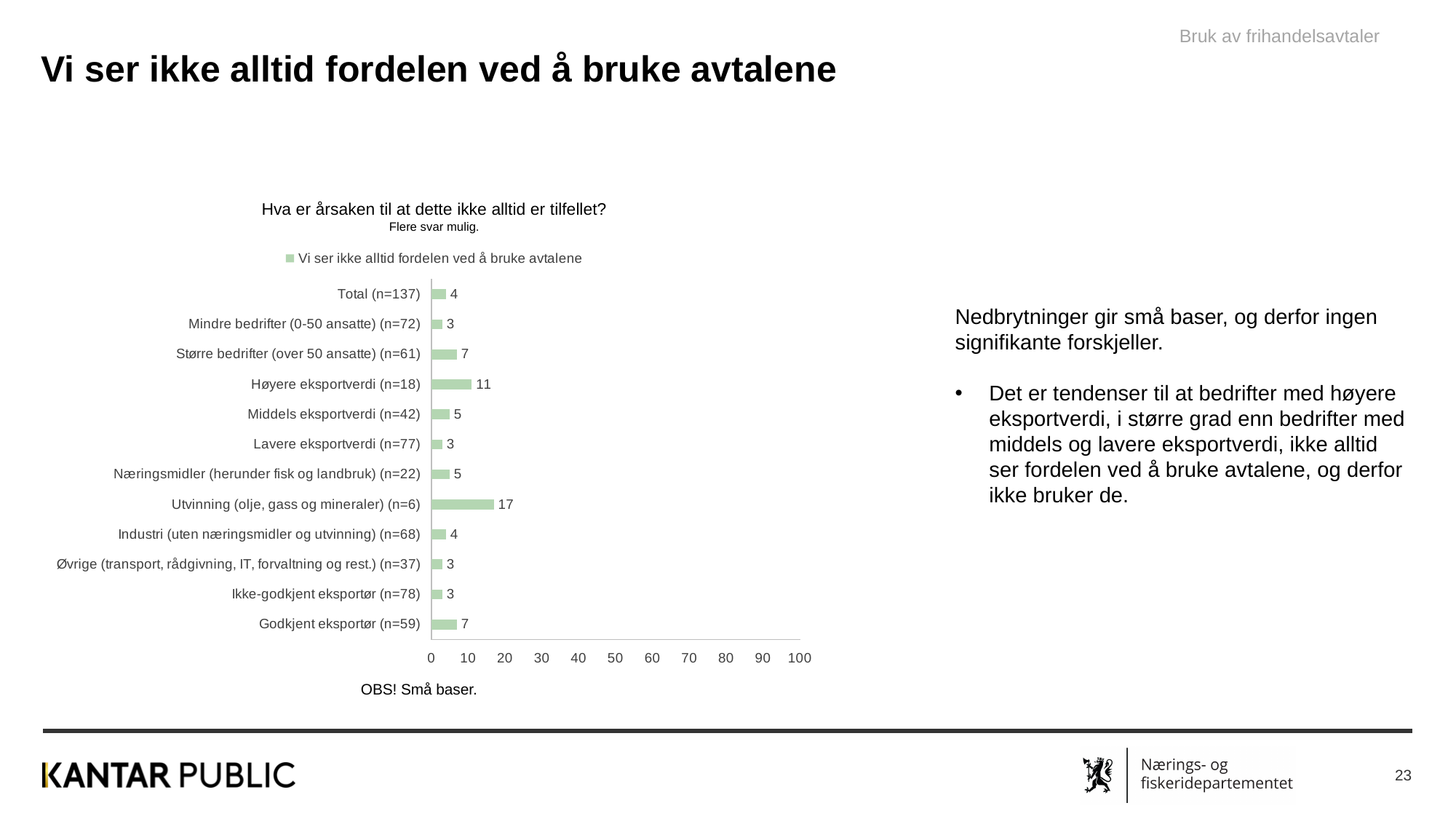
Is the value for Utvinning (olje, gass og mineraler) (n=6) greater or less than 10? greater What is the legend entry of the chart? Vi ser ikke alltid fordelen ved å bruke avtalene Which category has the highest value? Utvinning (olje, gass og mineraler) (n=6) How many series does the legend list? 1 What is the value for Utvinning (olje, gass og mineraler) (n=6)? 17 Which is larger: the value for Større bedrifter (over 50 ansatte) (n=61) or Mindre bedrifter (0-50 ansatte) (n=72)? Større bedrifter (over 50 ansatte) (n=61) What is the value for Godkjent eksportør (n=59)? 7 What is the difference between the values for Utvinning (olje, gass og mineraler) (n=6) and Høyere eksportverdi (n=18)? 6 What kind of chart is shown on the slide? Bar chart What is the value for Total (n=137)? 4 How many categories are shown in the chart? 12 What is the value for Høyere eksportverdi (n=18)? 11